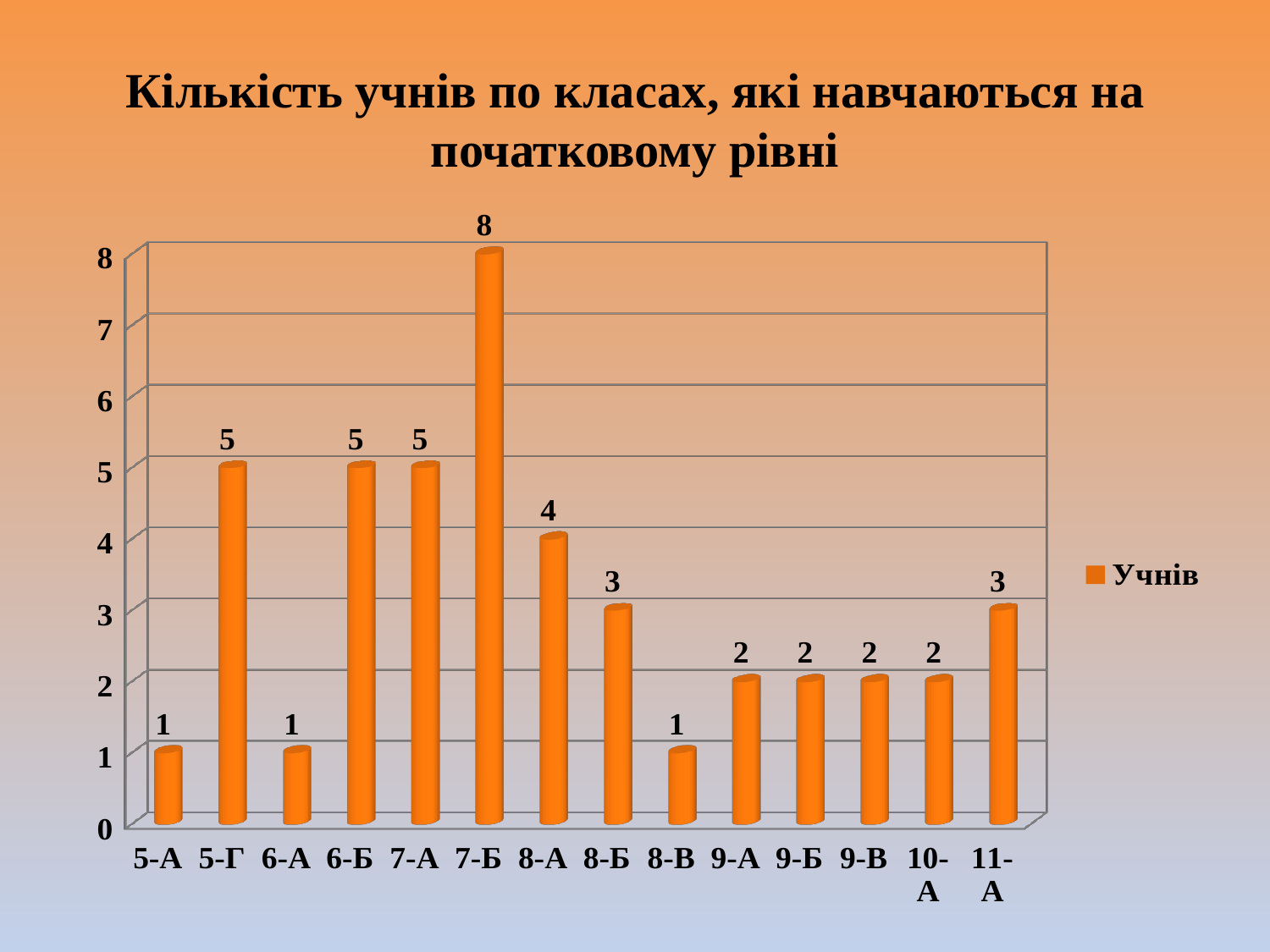
What is the value for 8-А? 4 What is the value for 7-Б? 8 How many classes are shown on the x axis? 14 Which is larger, the value for 8-А or the value for 9-А? 8-А What is the value for 9-Б? 2 Which class has the highest value? 7-Б What kind of chart is shown on the slide? bar chart How many series does the legend list? 1 What is the value for 11-А? 3 What is the difference between the values for 5-Г and 5-А? 4 What is the difference between the values for 7-Б and 8-Б? 5 What is the legend entry for the series? Учнів